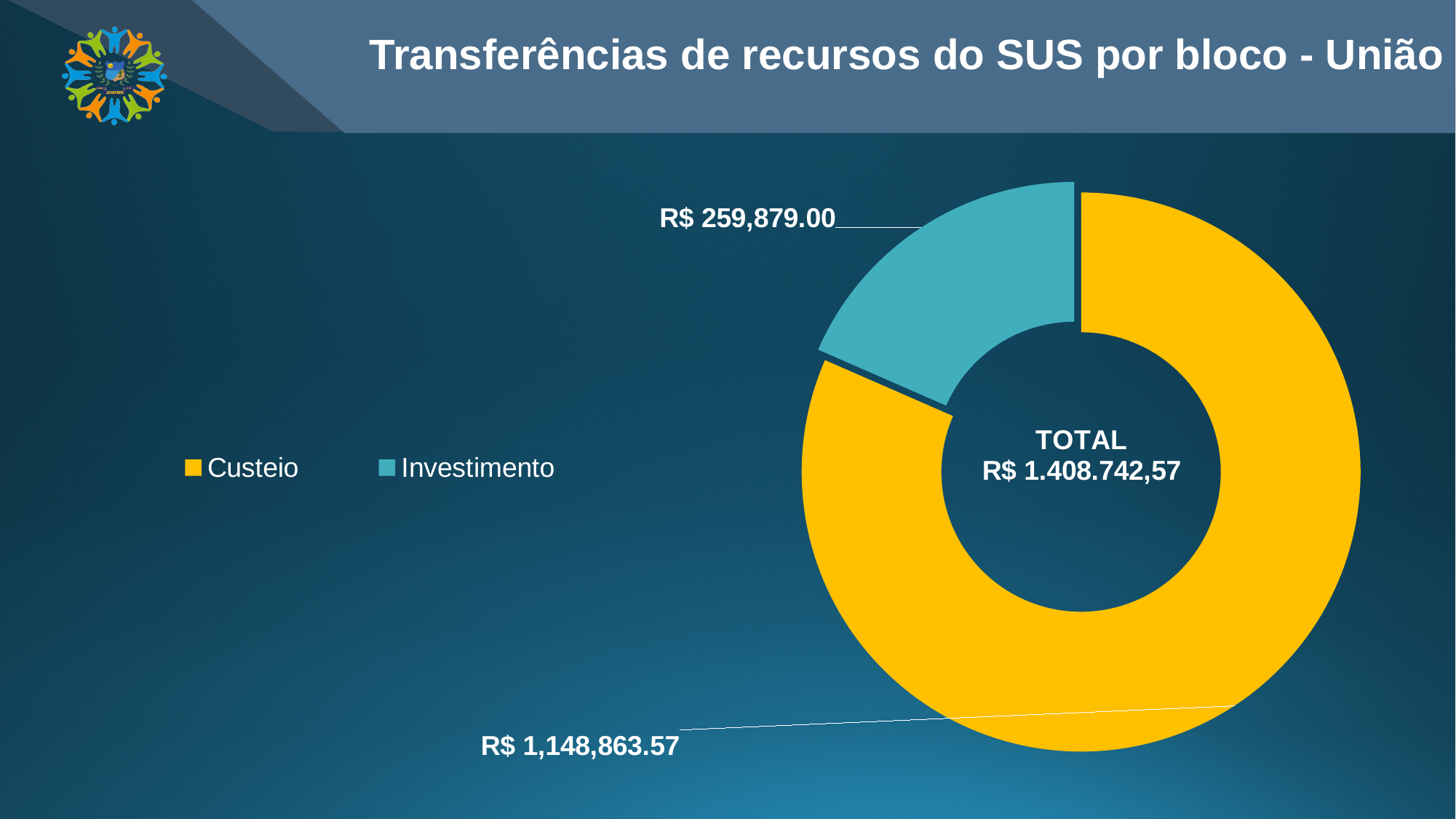
Which is larger, Custeio or Investimento? Custeio What total is shown in the centre of the chart? R$ 1.408.742,57 What colour is the Investimento slice? teal Which category has the smallest slice? Investimento Which category has the largest slice? Custeio What is the value for Investimento? R$ 259,879.00 What is the difference between the Custeio and Investimento values? R$ 888,984.57 What is the value for Custeio? R$ 1,148,863.57 How many entries does the legend list? 2 What kind of chart is shown on the slide? doughnut chart How many categories does the chart show? 2 What is the title of the slide? Transferências de recursos do SUS por bloco - União